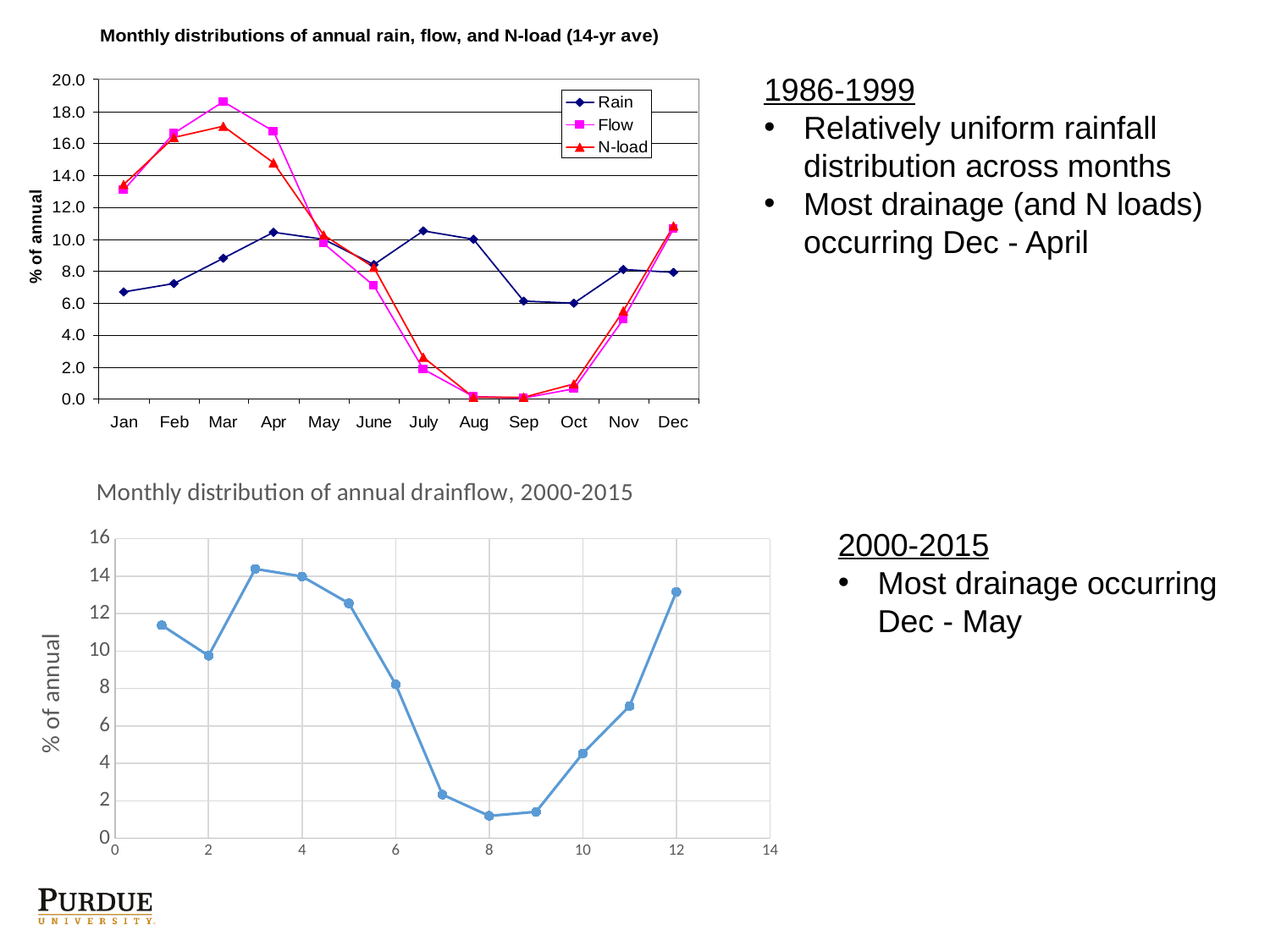
In the top chart, how many months are shown on the x axis? 12 In the top chart, does the Flow series rise or fall from Mar to Aug? Fall In the bottom chart, is the value at x = 12 greater or less than 12? greater In the top chart, which is larger in Aug, Rain or Flow? Rain In the top chart, which month has the highest Flow value? Mar What kind of chart is the top chart titled 'Monthly distributions of annual rain, flow, and N-load (14-yr ave)'? Line chart In the top chart, is the Rain value for Jan greater or less than 8.0? less In the top chart, is the Flow value for Mar greater or less than 16.0? greater In the top chart, how many series does the legend list? 3 In the top chart, which is larger in Mar, Flow or Rain? Flow What kind of chart is the bottom chart titled 'Monthly distribution of annual drainflow, 2000-2015'? Line chart